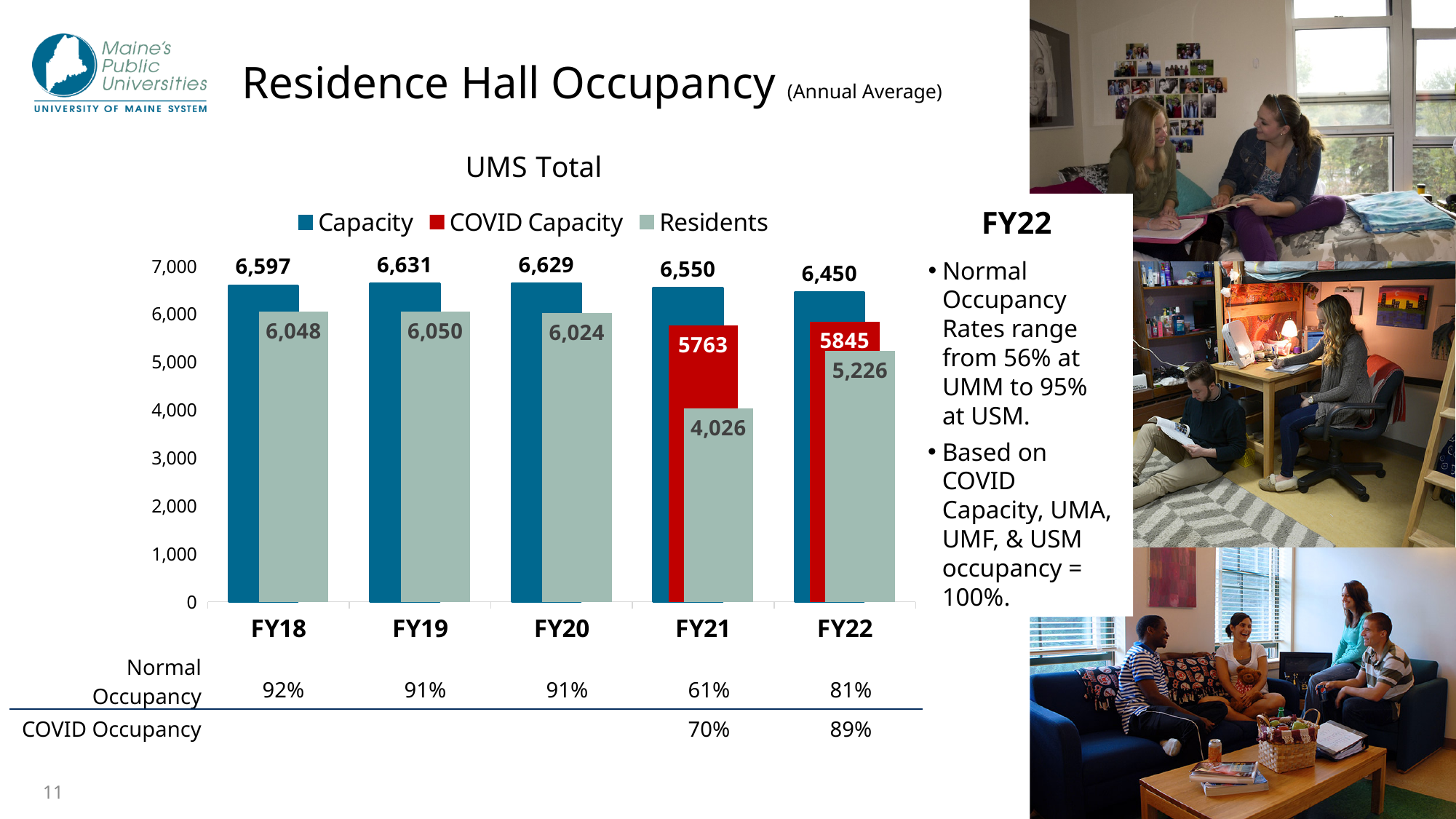
What is the Residents value for FY21? 4,026 How many fiscal years are shown on the x axis? 5 Which fiscal year has the highest Capacity? FY19 How many series does the legend list? 3 What colour represents COVID Capacity in the chart? red What is the COVID Capacity value for FY22? 5845 Which is larger, the Residents value for FY19 or for FY20? FY19 What is the difference between Capacity and Residents in FY22? 1,224 Is the Residents value for FY21 greater or less than 5,000? less Which fiscal year has the lowest Residents value? FY21 What kind of chart is shown? bar chart What is the Capacity value for FY18? 6,597